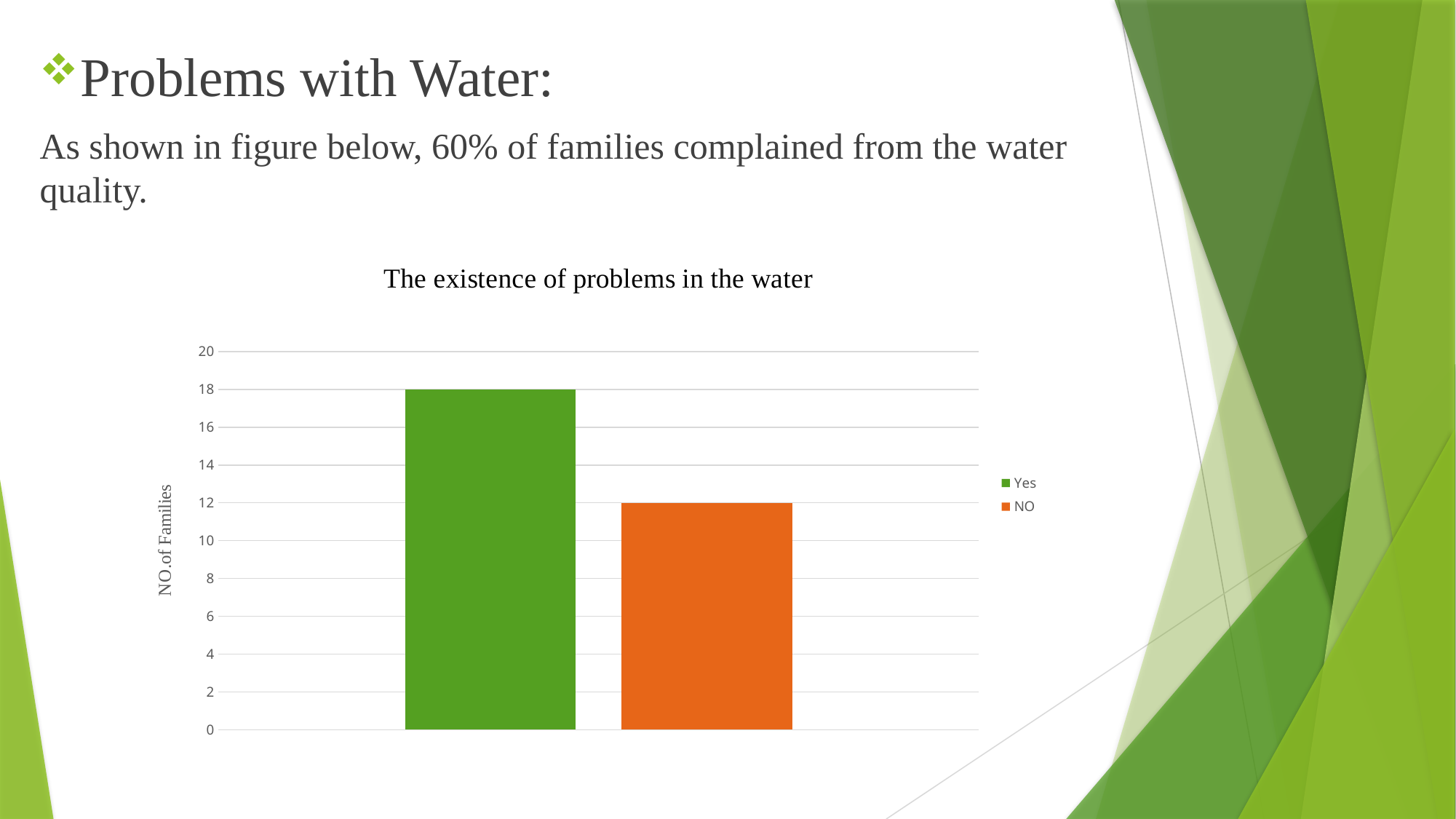
Which series has the lowest value in the chart? NO How many bars are plotted in the chart? 2 How many series does the chart legend list? 2 What type of chart is shown on the slide? bar chart Is the value for Yes greater or less than 16? greater What is the value for NO in the chart? 12 What is the value for Yes in the chart? 18 What is the title of the chart? The existence of problems in the water What is the label of the vertical axis? NO.of Families What is the difference between the values for Yes and NO? 6 Is the value for NO greater or less than 14? less Which series has the highest value, Yes or NO? Yes